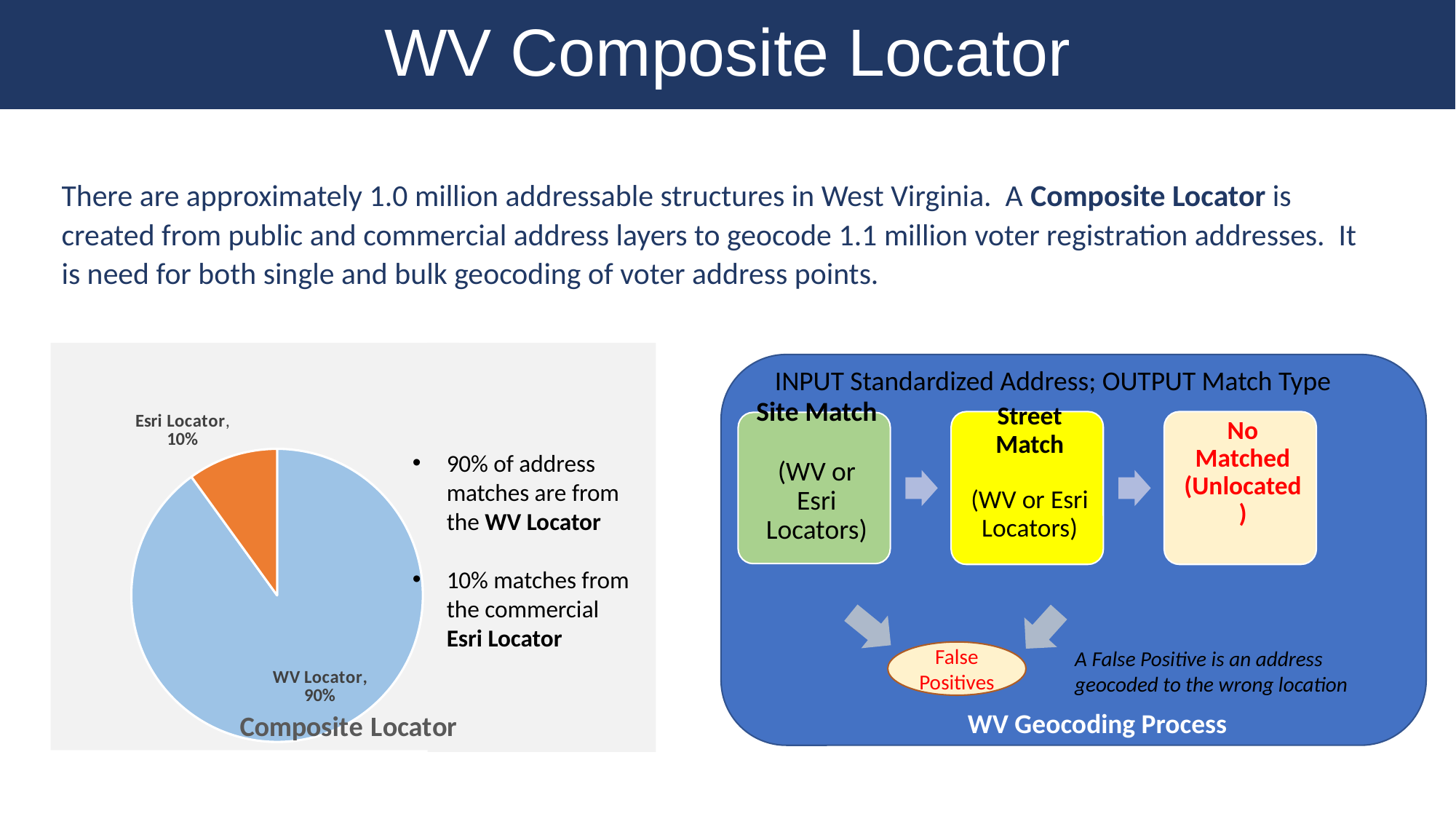
Which slice of the pie chart is the smallest? Esri Locator Which is larger, the WV Locator slice or the Esri Locator slice? WV Locator What share of the pie does WV Locator have? 90% What is the difference in percentage points between the WV Locator and Esri Locator slices? 80 What is the title of the pie chart? Composite Locator What kind of chart is shown on the slide? pie chart What share of the pie does Esri Locator have? 10% How many slices does the pie chart have? 2 What colour is the Esri Locator slice in the pie chart? orange Which slice of the pie chart is the largest? WV Locator